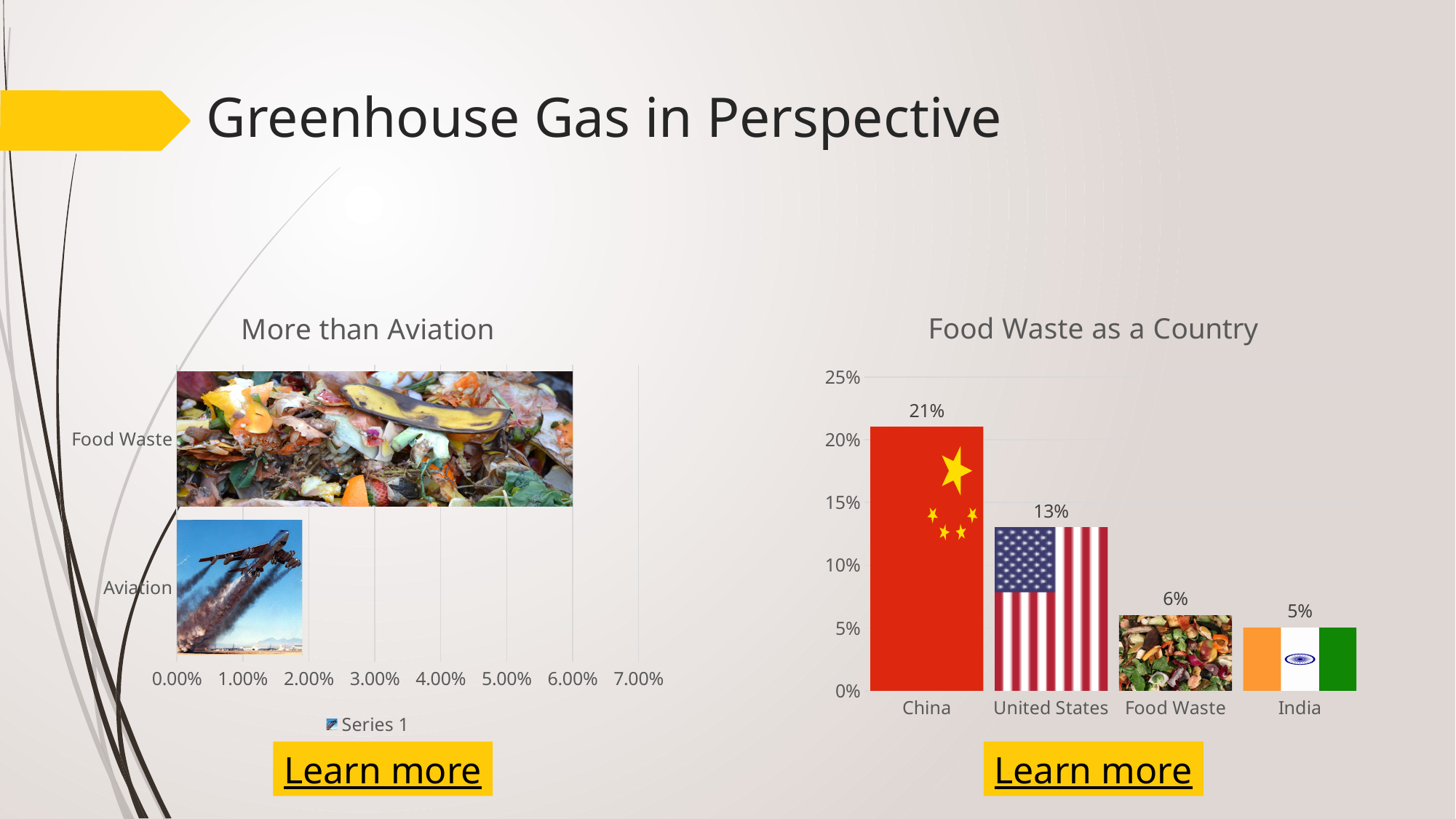
In the 'More than Aviation' chart, is the value for Aviation greater or less than 3.00%? less How many categories are shown in the 'Food Waste as a Country' chart? 4 In the 'Food Waste as a Country' chart, which category has the lowest value? India What kind of chart is the 'More than Aviation' chart? Bar chart What series name does the legend of the 'More than Aviation' chart show? Series 1 In the 'Food Waste as a Country' chart, what is the value for the United States? 13% In the 'Food Waste as a Country' chart, which is larger, the value for Food Waste or the value for India? Food Waste In the 'Food Waste as a Country' chart, what is the value for India? 5% In the 'More than Aviation' chart, is the value for Food Waste greater or less than 5.00%? greater In the 'Food Waste as a Country' chart, what is the value for China? 21% In the 'Food Waste as a Country' chart, what is the difference between the values for China and the United States? 8% In the 'Food Waste as a Country' chart, which category has the highest value? China